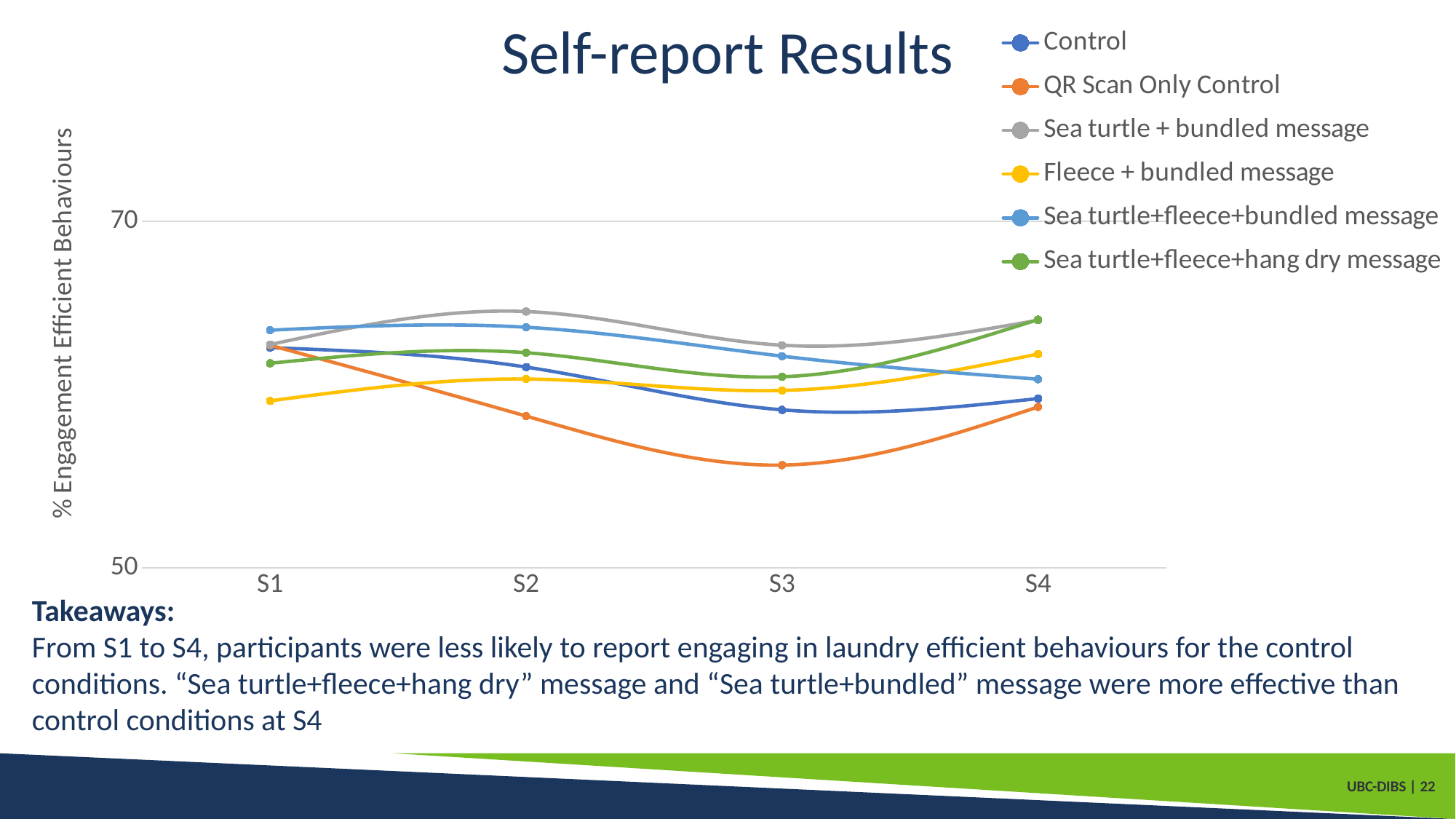
What is the label on the y axis? % Engagement Efficient Behaviours Which series has the lowest value at S1? Fleece + bundled message Which series has the lowest value at S2? QR Scan Only Control What kind of chart is shown on the slide? line chart How many series does the legend list? 6 Does the QR Scan Only Control series rise or fall from S1 to S3? fall Is the value for QR Scan Only Control at S3 greater or less than 70? less At S4, which is higher: Fleece + bundled message or Control? Fleece + bundled message Which series has the lowest value at S3? QR Scan Only Control How many time points are shown along the x axis? 4 What is the title of the chart? Self-report Results At S3, which is higher: Sea turtle + bundled message or QR Scan Only Control? Sea turtle + bundled message